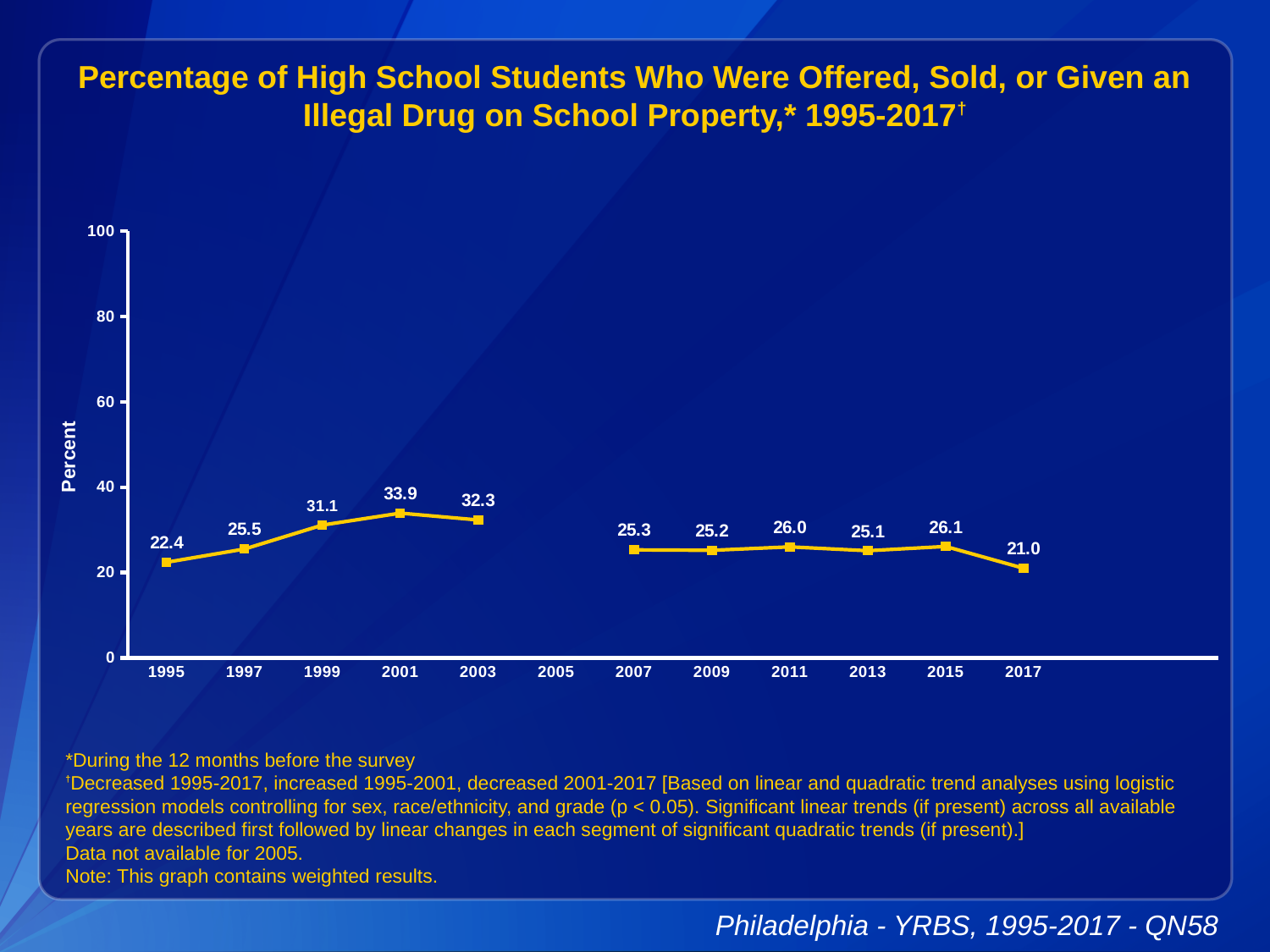
Which year has the lowest percentage? 2017 Which year has the highest percentage? 2001 What kind of chart is shown on the slide? line chart What value is shown for 2017? 21.0 What is the difference between the values for 2001 and 2017? 12.9 What value is shown for 2011? 26.0 Did the percentage rise or fall from 1995 to 2001? rise What was the percentage of high school students who were offered, sold, or given an illegal drug on school property in 1995? 22.4 Is the value for 2003 greater or less than 40? less How many years have data points plotted on the chart? 11 Which is larger, the value for 1999 or the value for 2015? 1999 For which year is data not available? 2005